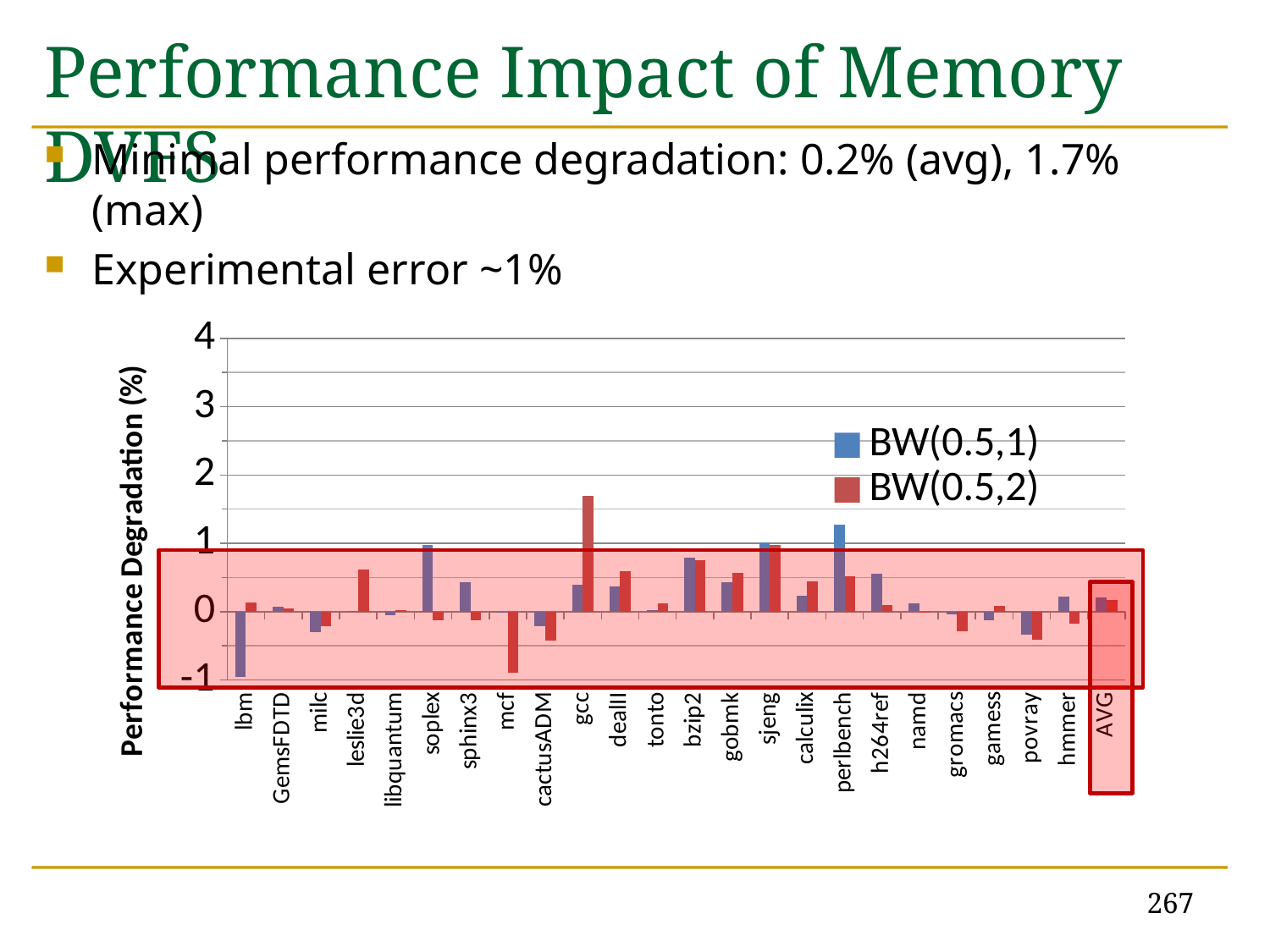
Is the BW(0.5,2) value for gcc greater or less than 1? greater Is the BW(0.5,2) value for mcf greater or less than 0? less Which category has the highest BW(0.5,1) value in the chart? perlbench How many series does the chart legend list? 2 What is the label of the vertical axis of the chart? Performance Degradation (%) Is the BW(0.5,1) value for perlbench greater or less than 1? greater For soplex, which series has the larger value, BW(0.5,1) or BW(0.5,2)? BW(0.5,1) How many categories are shown along the x axis of the chart, including AVG? 24 What are the two series named in the chart legend? BW(0.5,1) and BW(0.5,2) What kind of chart is shown on the slide? bar chart Which category has the highest BW(0.5,2) value in the chart? gcc